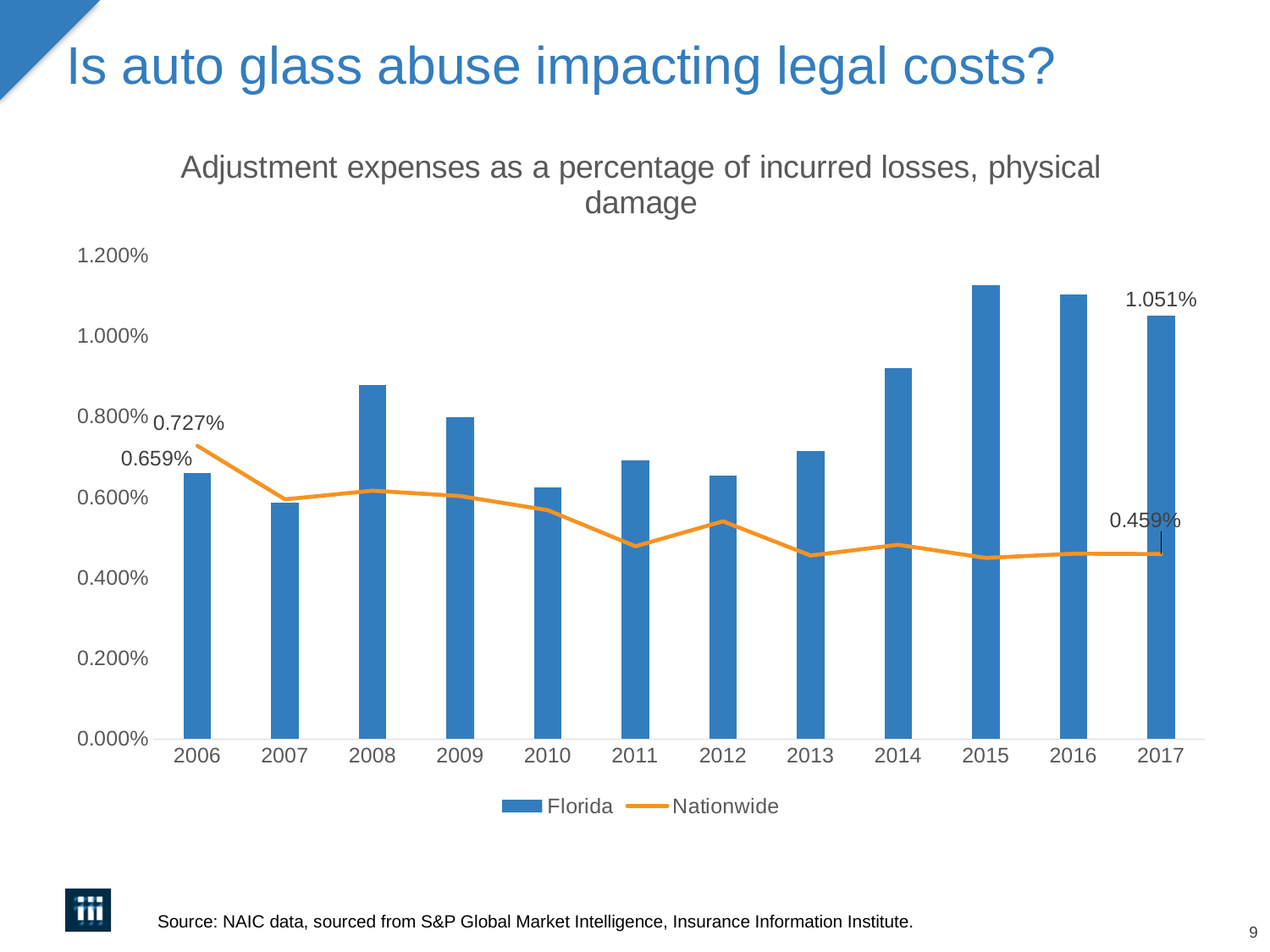
What is the Florida value for 2017? 1.051% In 2006, which is larger: the Florida value or the Nationwide value? Nationwide In which year is the Florida bar the lowest? 2007 What is the difference between the Florida and Nationwide values in 2017? 0.592% How many years are shown on the x axis? 12 In which year is the Florida bar the highest? 2015 Does the Nationwide line rise or fall from 2006 to 2017? fall How many series does the legend list? 2 What is the Nationwide value for 2017? 0.459% Is the Florida value for 2015 greater or less than 1.000%? greater What is the Nationwide value for 2006? 0.727% What is the Florida value for 2006? 0.659%